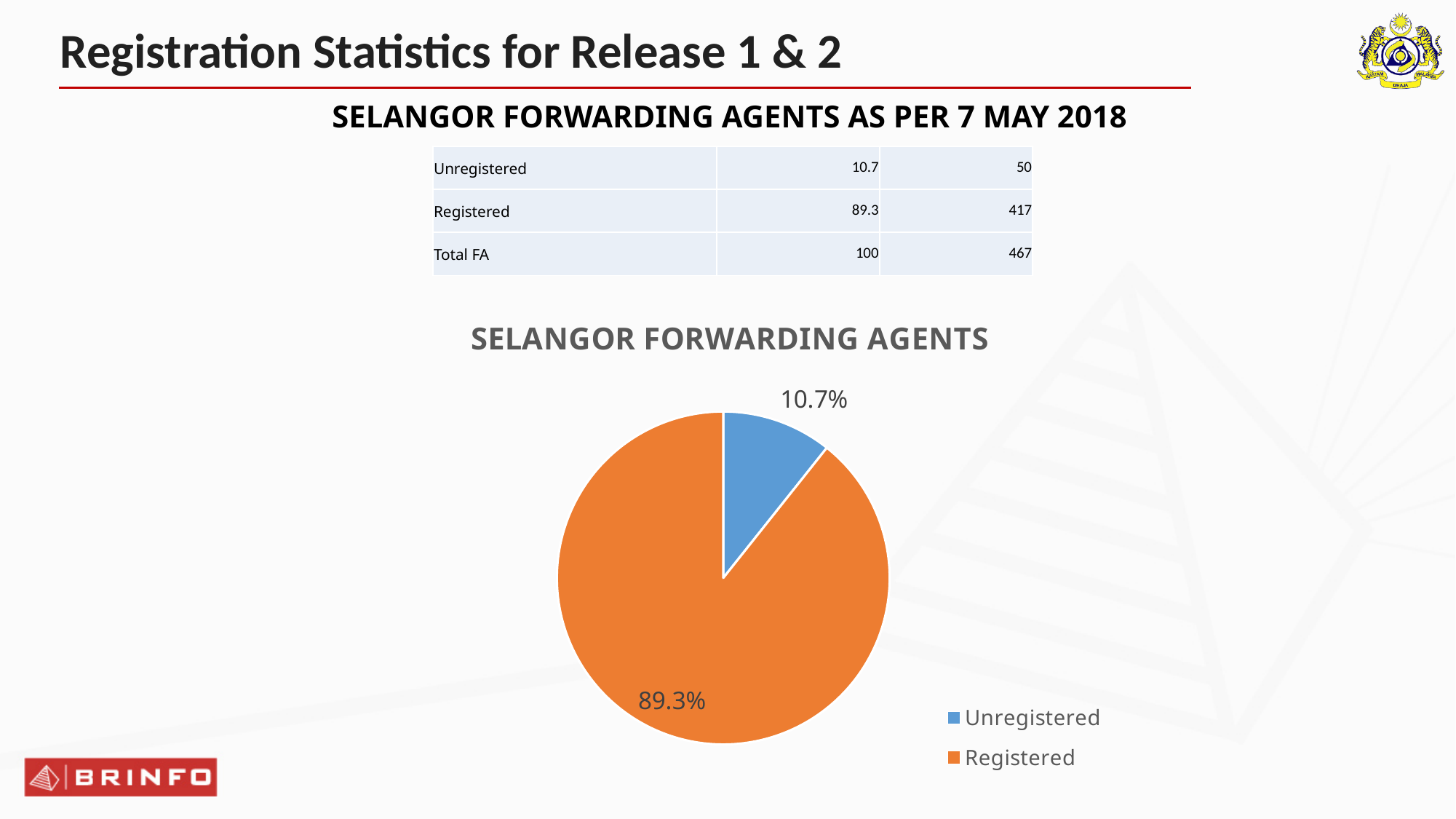
What type of chart is shown on the slide? Pie chart What colour is the Unregistered slice in the pie chart? Blue How many slices does the pie chart have? 2 Is the share for Registered greater or less than 50%? greater What percentage of the pie does the Unregistered slice represent? 10.7% What is the difference in percentage points between the Registered and Unregistered slices? 78.6 How many entries does the legend list? 2 Which category has the largest slice of the pie? Registered What percentage of the pie does the Registered slice represent? 89.3% What is the title of the chart? SELANGOR FORWARDING AGENTS Which category has the smallest slice of the pie? Unregistered Which is larger, the Registered slice or the Unregistered slice? Registered